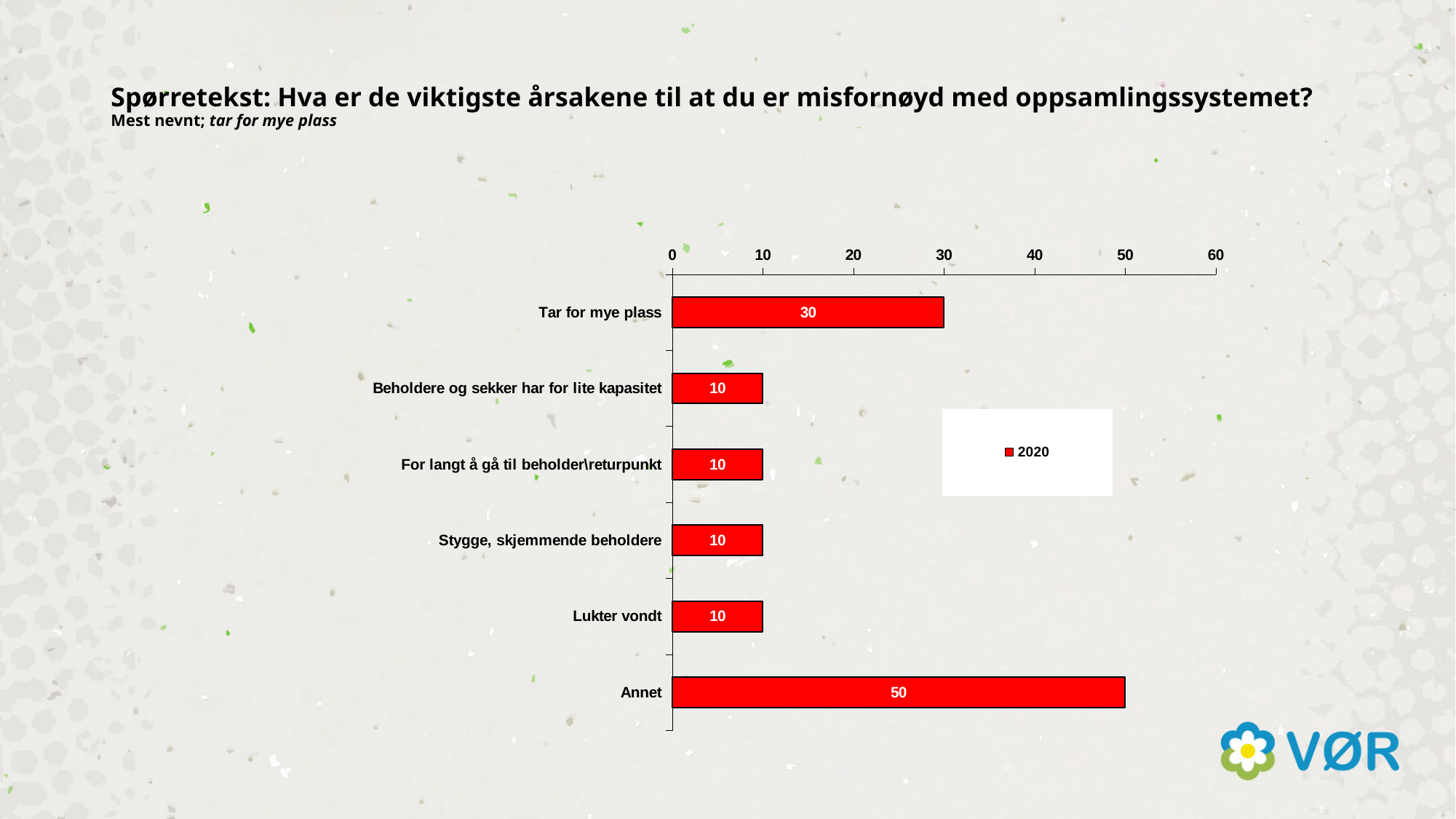
How many series does the legend list? 1 Which category has the highest value? Annet How many categories are shown in the chart? 6 What kind of chart is shown on the slide? Bar chart What is the value for "Beholdere og sekker har for lite kapasitet"? 10 What is the value for "Annet"? 50 What is the value for "Lukter vondt"? 10 What series name is shown in the legend? 2020 Which is larger, the value for "Tar for mye plass" or the value for "Stygge, skjemmende beholdere"? Tar for mye plass What is the value for "Tar for mye plass"? 30 What is the difference between the values for "Annet" and "Tar for mye plass"? 20 Is the value for "Annet" greater or less than 40? greater